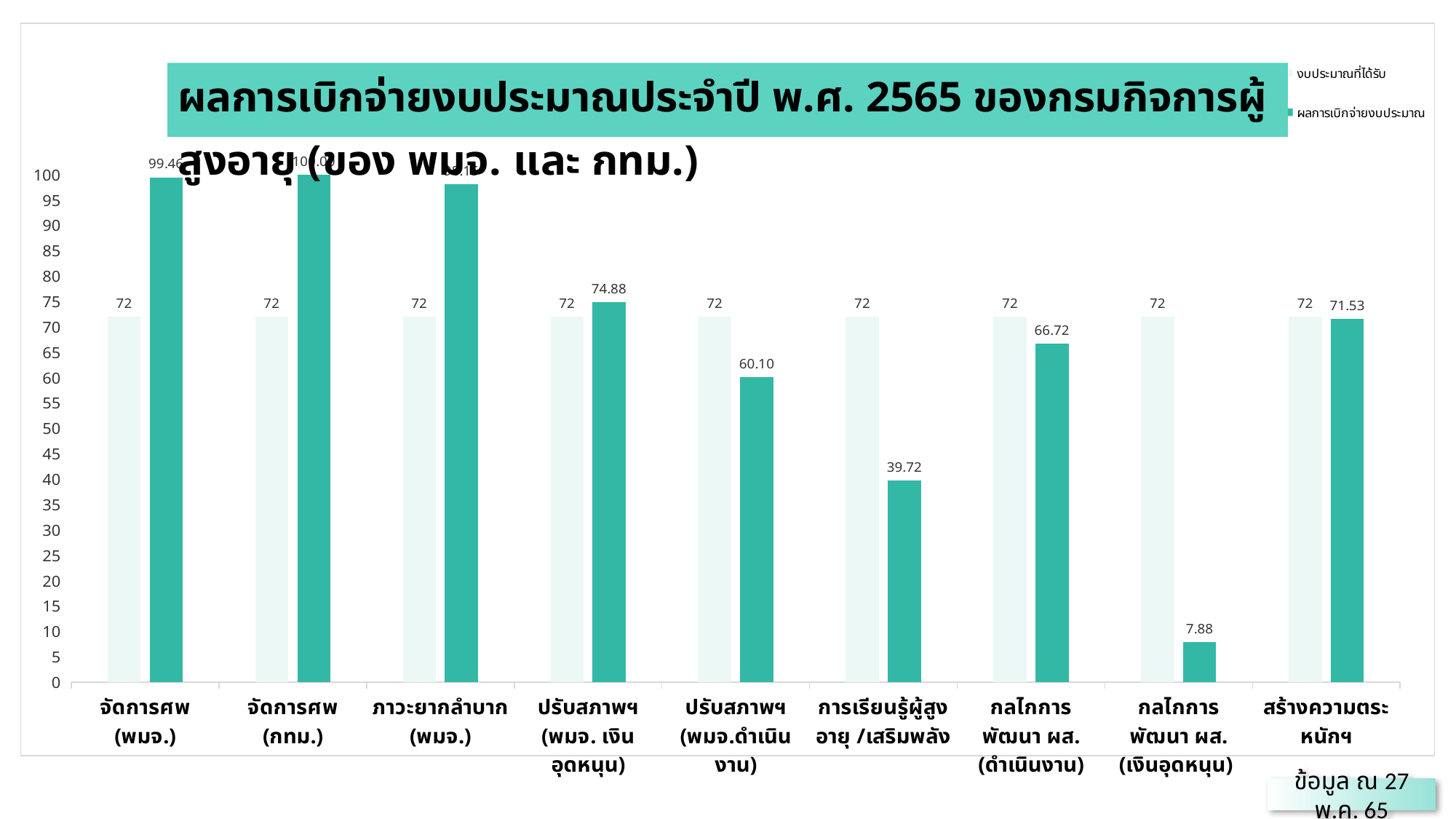
What is the ผลการเบิกจ่ายงบประมาณ value for ปรับสภาพฯ (พมจ. เงินอุดหนุน)? 74.88 Is the ผลการเบิกจ่ายงบประมาณ value for จัดการศพ (พมจ.) greater or less than 90? greater What is the second legend entry of the chart? ผลการเบิกจ่ายงบประมาณ What is the งบประมาณที่ได้รับ value for สร้างความตระหนักฯ? 72 Which is larger: the ผลการเบิกจ่ายงบประมาณ value for สร้างความตระหนักฯ or for กลไกการพัฒนา ผส. (ดำเนินงาน)? สร้างความตระหนักฯ What is the ผลการเบิกจ่ายงบประมาณ value for การเรียนรู้ผู้สูงอายุ /เสริมพลัง? 39.72 Which category has the lowest ผลการเบิกจ่ายงบประมาณ value? กลไกการพัฒนา ผส. (เงินอุดหนุน) What type of chart is shown on the slide? bar chart How many series does the legend list? 2 What is the ผลการเบิกจ่ายงบประมาณ value for กลไกการพัฒนา ผส. (เงินอุดหนุน)? 7.88 How many categories are shown on the x axis? 9 What is the difference between the ผลการเบิกจ่ายงบประมาณ values for กลไกการพัฒนา ผส. (ดำเนินงาน) and ปรับสภาพฯ (พมจ.ดำเนินงาน)? 6.62